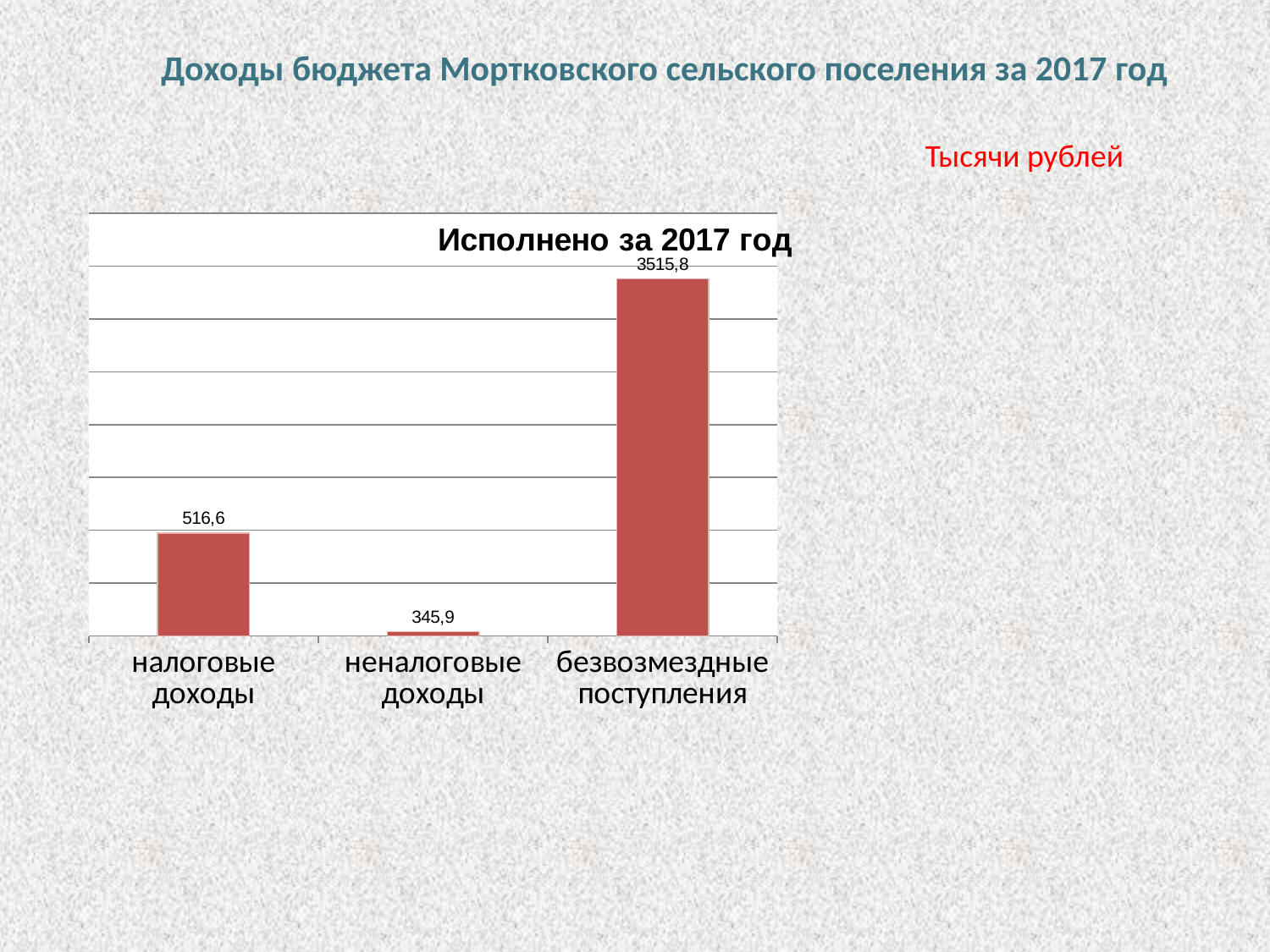
What type of chart is shown on the slide? bar chart Which category has the highest value? безвозмездные поступления How many categories are shown in the chart? 3 What is the value for неналоговые доходы? 345,9 Which is larger, налоговые доходы or безвозмездные поступления? безвозмездные поступления What is the title of the chart? Исполнено за 2017 год What is the value for налоговые доходы? 516,6 What is the difference between безвозмездные поступления and налоговые доходы? 2999,2 What is the difference between налоговые доходы and неналоговые доходы? 170,7 What is the value for безвозмездные поступления? 3515,8 In what units are the chart values given, according to the slide? Тысячи рублей Which category has the lowest value? неналоговые доходы